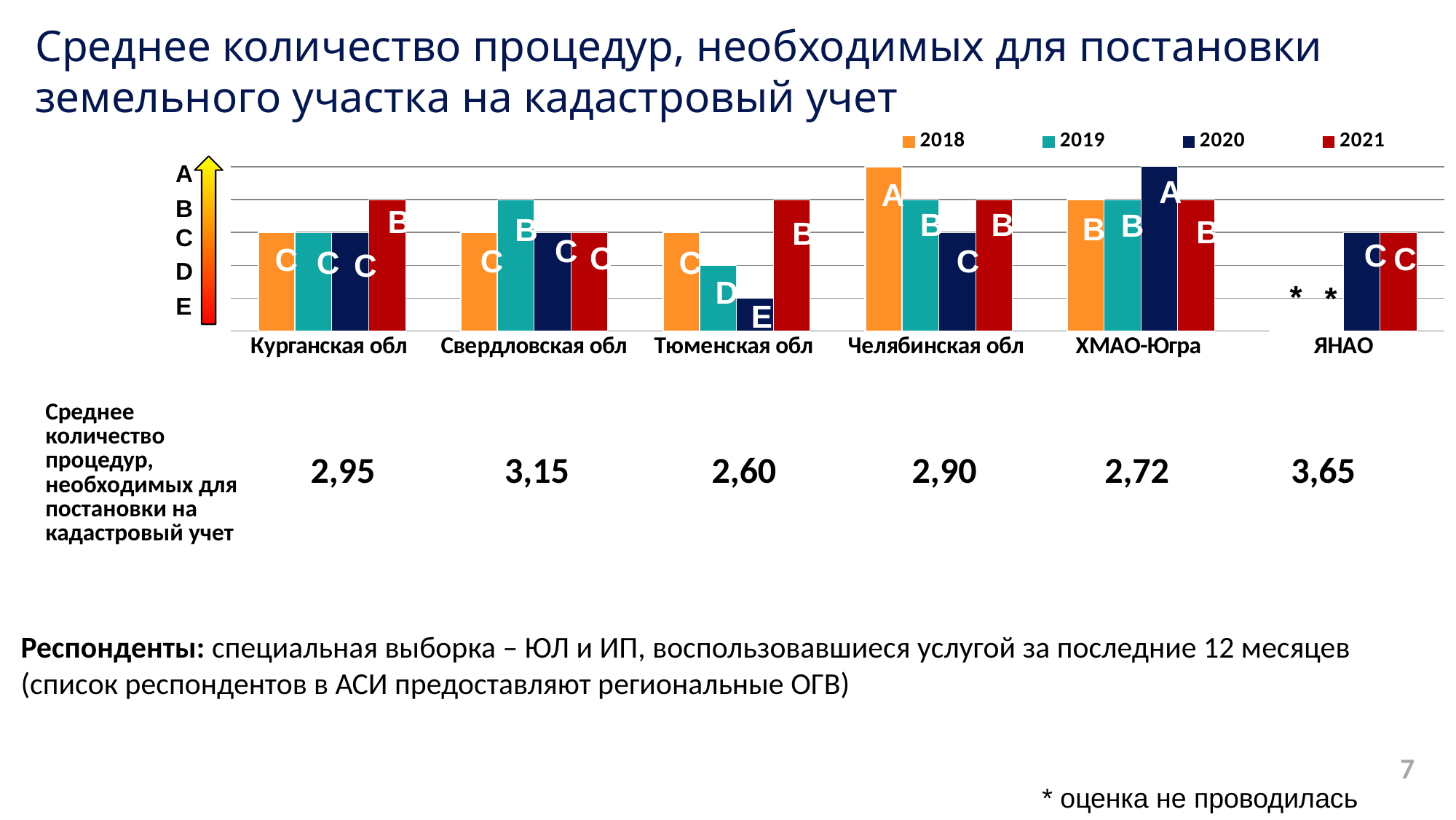
What grade did Челябинская обл receive in 2018? A For which years is ЯНАО marked with an asterisk (assessment not conducted)? 2018 and 2019 Which region has the lowest average number of procedures shown below the chart? Тюменская обл What grade did Свердловская обл receive in 2019? B How many series (years) does the legend list? 4 How many regions are shown on the x axis of the chart? 6 What grade did Тюменская обл receive in 2020? E What grade did ХМАО-Югра receive in 2020? A What grade did Курганская обл receive in 2021? B What is the average number of procedures shown for ЯНАО? 3,65 Which region has the highest average number of procedures shown below the chart? ЯНАО What type of chart is shown on the slide? Bar chart